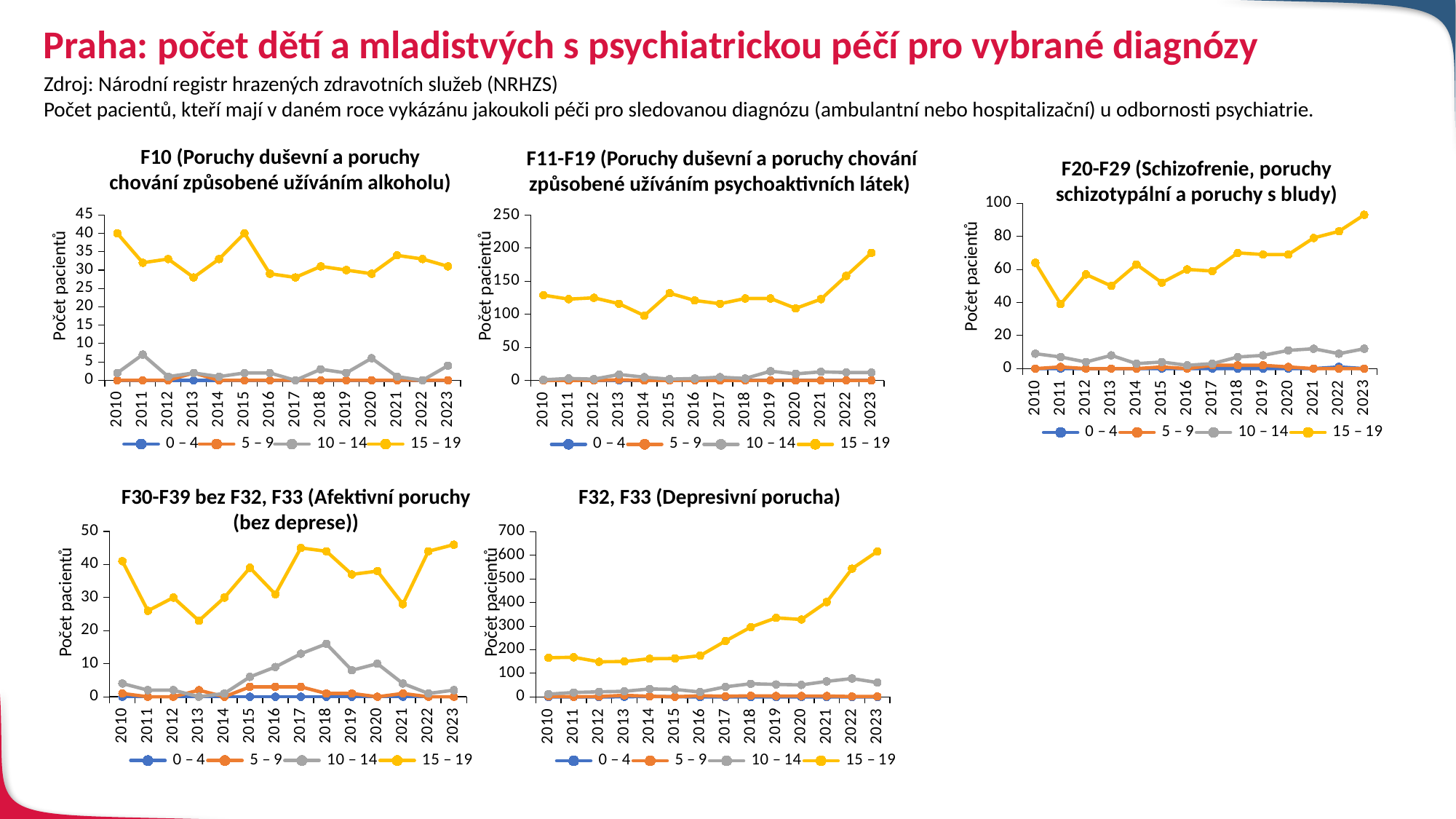
In the F11-F19 chart, is the value for 15 – 19 in 2023 greater or less than 150? greater In the F20-F29 (Schizofrenie) chart, in which year is the 15 – 19 series lowest? 2011 In the F30-F39 bez F32, F33 chart, in which year is the 10 – 14 series highest? 2018 In the F32, F33 (Depresivní porucha) chart, which is larger for the 15 – 19 series: the value in 2010 or in 2023? 2023 In the F32, F33 (Depresivní porucha) chart, how many years are shown on the x axis? 14 In the F20-F29 (Schizofrenie) chart, is the value for 15 – 19 in 2023 greater or less than 80? greater In the F30-F39 bez F32, F33 chart, in which year is the 15 – 19 series lowest? 2013 In the F10 chart, how many series does the legend list? 4 What kind of chart is the F10 (Poruchy duševní a poruchy chování způsobené užíváním alkoholu) chart? Line chart In the F32, F33 (Depresivní porucha) chart, is the value for 15 – 19 in 2023 greater or less than 500? greater In the F32, F33 (Depresivní porucha) chart, does the 15 – 19 series generally rise or fall from 2010 to 2023? Rise What is the y-axis label on the F10 chart? Počet pacientů